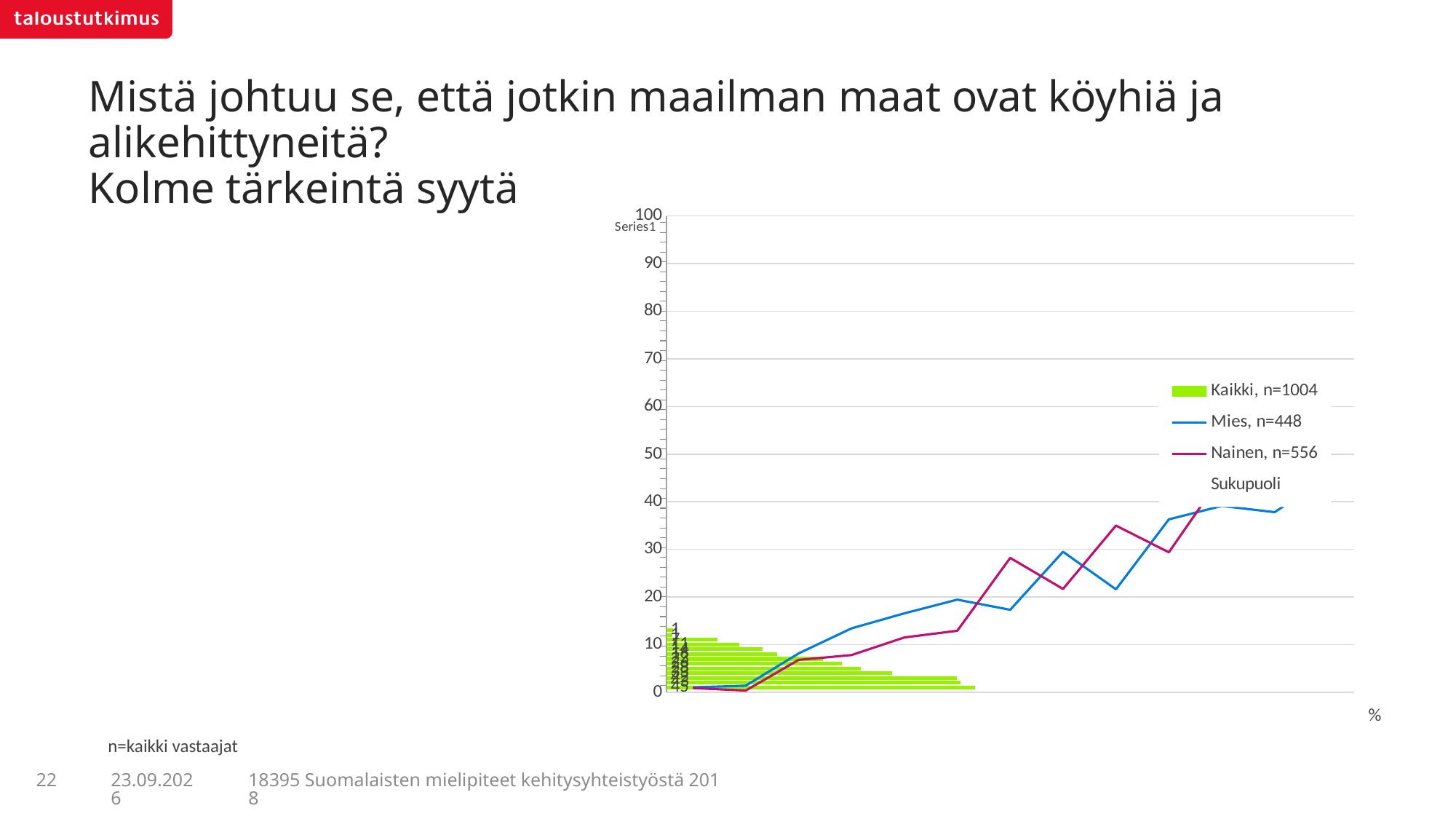
How many series does the chart legend list? 4 What sample size (n) is given for the Mies series in the legend? 448 Is the highest point of the Mies line greater or less than 30? greater Is the lowest point of the Nainen line greater or less than 10? less Do the values of the Mies line generally rise or fall from left to right? rise Is the highest point of the Mies line greater or less than 50? less Do the values of the Nainen line generally rise or fall from left to right? rise